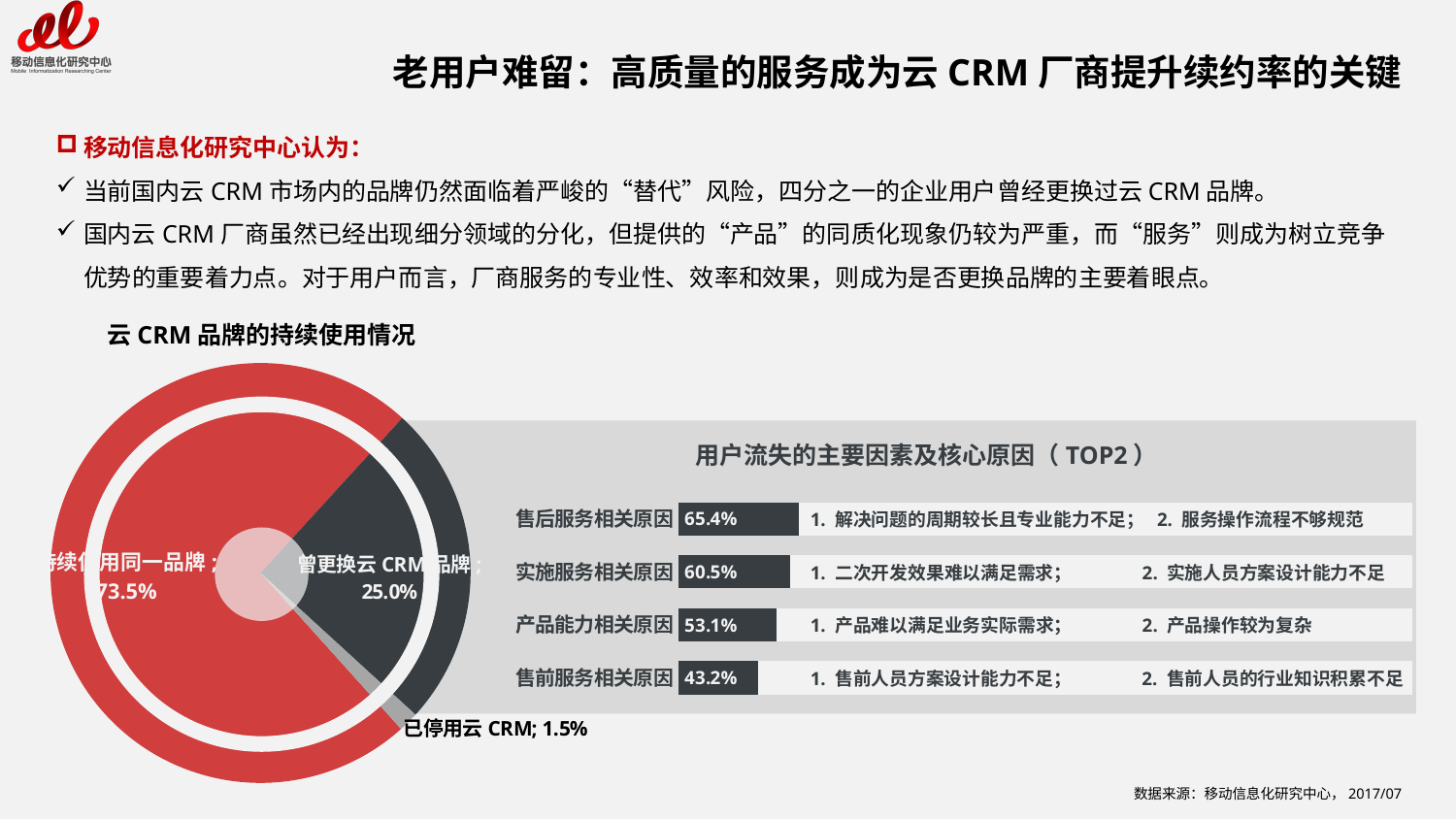
在“云 CRM 品牌的持续使用情况”饼图中，“持续使用同一品牌”的占比是多少？ 73.5% 在“用户流失的主要因素及核心原因（TOP2）”条形图中，“实施服务相关原因”与“产品能力相关原因”的数值相差多少？ 7.4% “云 CRM 品牌的持续使用情况”这个图表是什么类型的图表？ 饼图 在“用户流失的主要因素及核心原因（TOP2）”条形图中，“售前服务相关原因”的数值是多少？ 43.2% 在“云 CRM 品牌的持续使用情况”饼图中，“已停用云 CRM”的占比是多少？ 1.5% “用户流失的主要因素及核心原因（TOP2）”条形图共列出了几个类别？ 4 在“云 CRM 品牌的持续使用情况”饼图中，占比最小的类别是哪一个？ 已停用云 CRM “云 CRM 品牌的持续使用情况”饼图共有几个扇区？ 3 在“用户流失的主要因素及核心原因（TOP2）”条形图中，“售后服务相关原因”的数值是多少？ 65.4% 在“用户流失的主要因素及核心原因（TOP2）”条形图中，“产品能力相关原因”和“售前服务相关原因”哪个数值更大？ 产品能力相关原因 在“云 CRM 品牌的持续使用情况”饼图中，“曾更换云 CRM 品牌”的占比是多少？ 25.0% 在“用户流失的主要因素及核心原因（TOP2）”条形图中，数值最高的类别是哪一个？ 售后服务相关原因